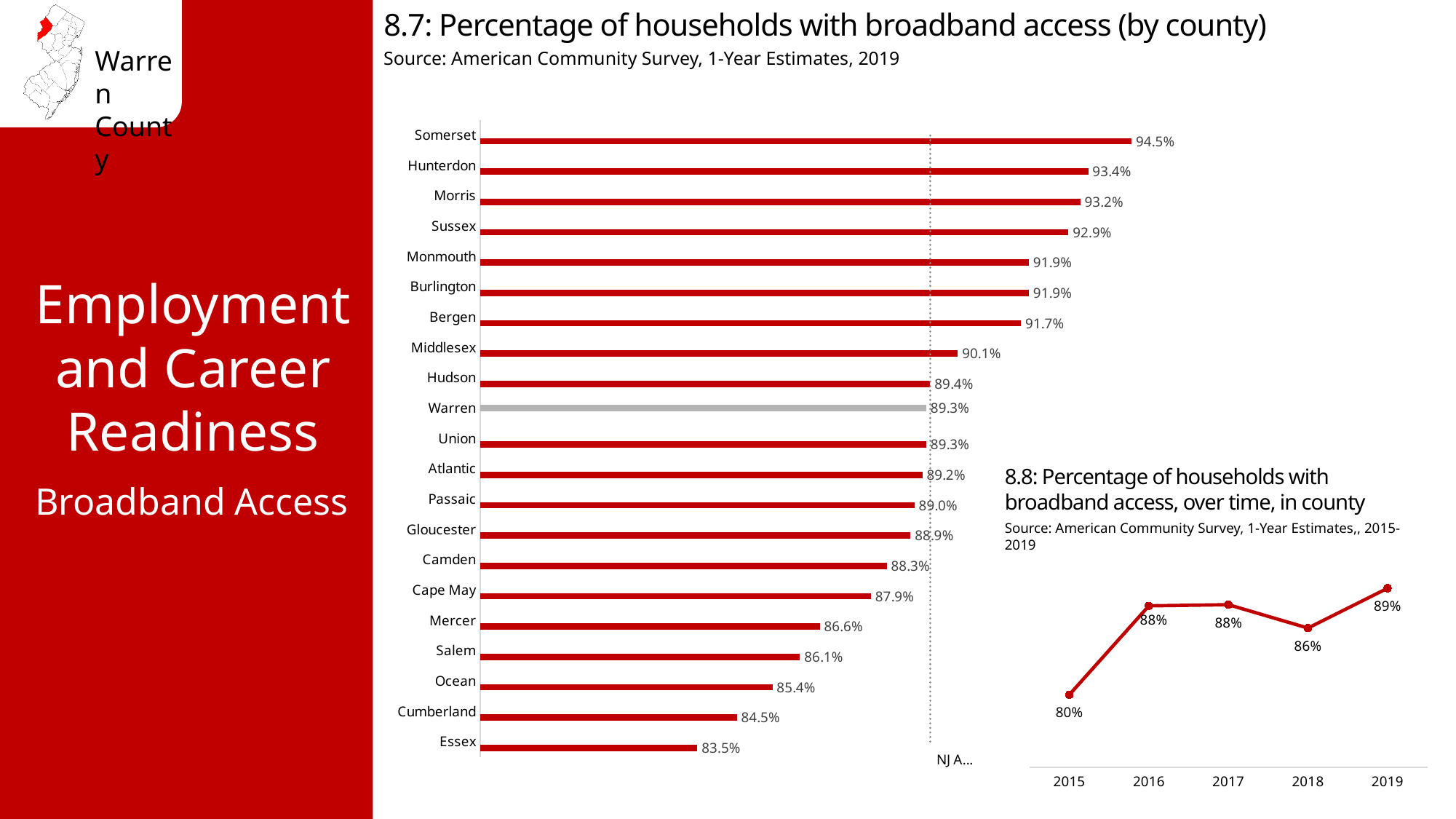
In chart 8.7, which county has the lowest percentage of households with broadband access? Essex In chart 8.7, what is the difference between Somerset's and Essex's percentages? 11.0% In chart 8.8, which year has the highest percentage of households with broadband access? 2019 In chart 8.7, which county has the highest percentage of households with broadband access? Somerset In chart 8.7, what is the percentage of households with broadband access in Warren County? 89.3% What kind of chart is chart 8.8? Line chart What kind of chart is chart 8.7? Bar chart In chart 8.7, how many counties are shown? 21 In chart 8.7, which county has a higher percentage of households with broadband access, Hudson or Mercer? Hudson In chart 8.8, what is the difference between the 2019 and 2015 values? 9% In chart 8.8, what was the percentage of households with broadband access in 2015? 80% In chart 8.7, what is the percentage of households with broadband access in Cumberland County? 84.5%